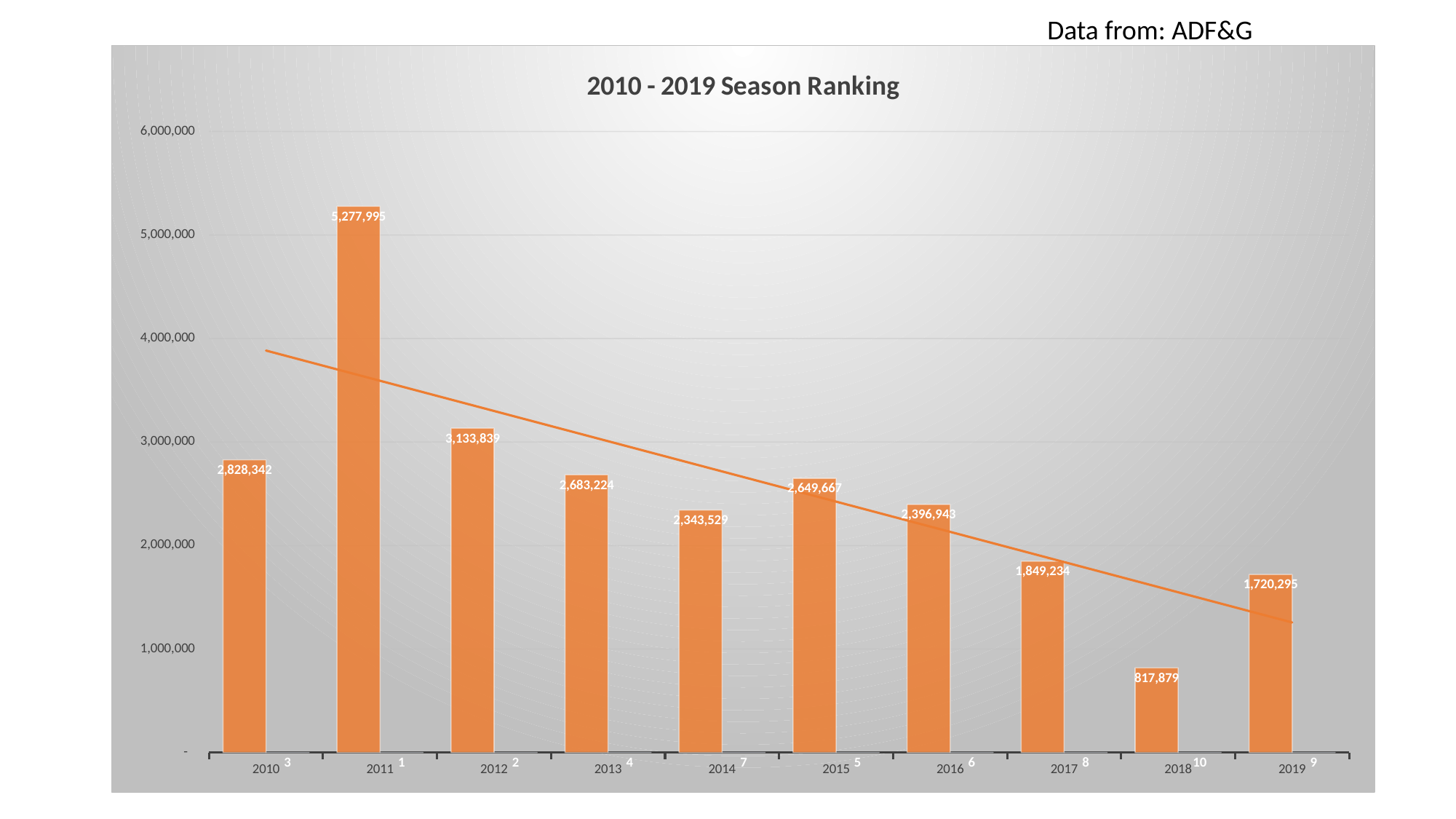
Which year has the lowest value? 2018 What is the title of the chart? 2010 - 2019 Season Ranking Is the value for 2017 greater or less than 2,000,000? less What is the difference between the values for 2011 and 2010? 2,449,653 Which year has the highest value? 2011 What is the value for 2018? 817,879 Which is larger, the value for 2012 or the value for 2016? 2012 How many years are shown on the x axis? 10 What is the difference between the values for 2019 and 2018? 902,416 What is the value for 2011 in the 2010 - 2019 Season Ranking chart? 5,277,995 What is the value for 2015? 2,649,667 What kind of chart is this? bar chart